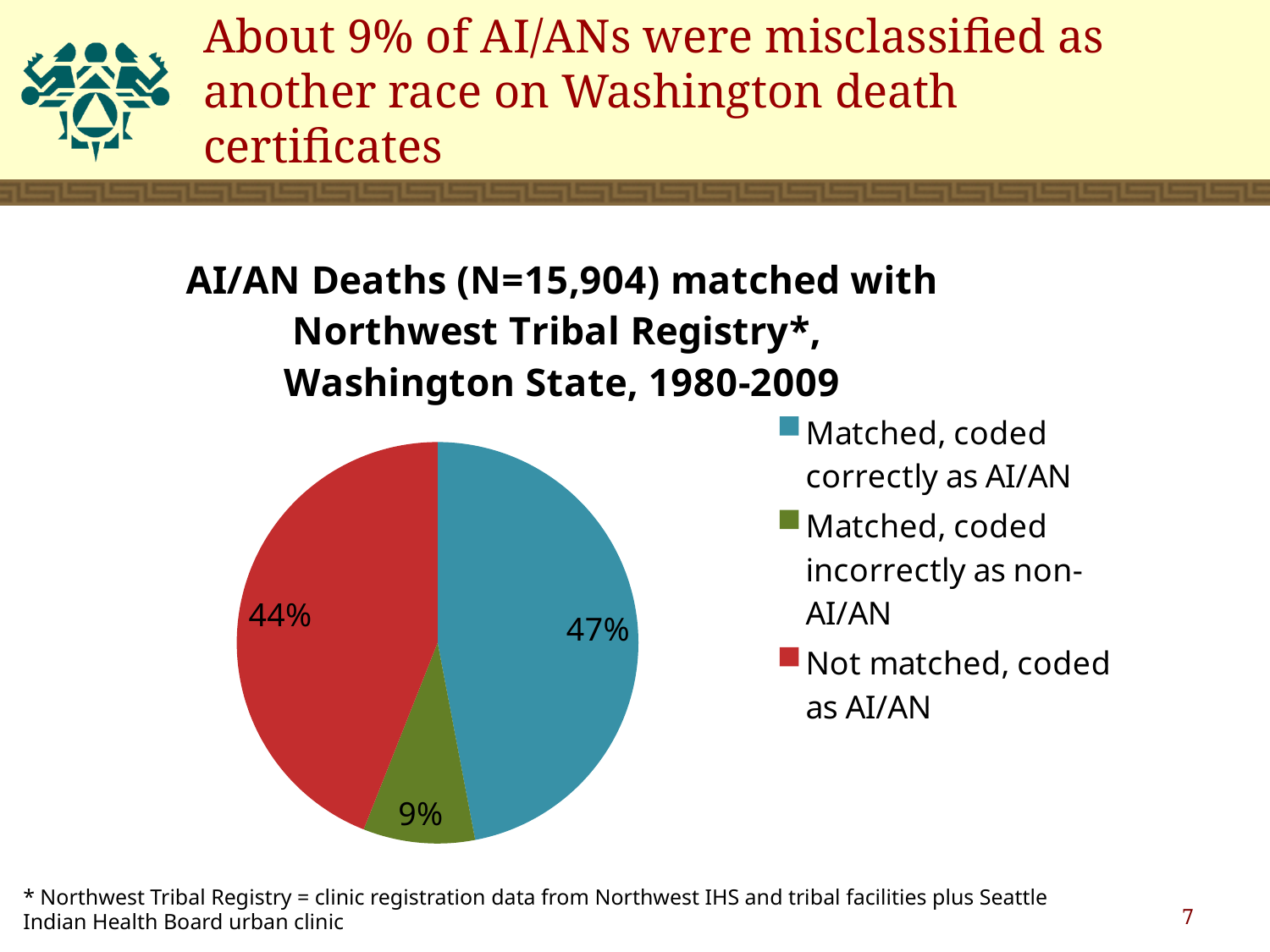
What share of AI/AN deaths were matched but coded incorrectly as non-AI/AN? 9% What is the total N of AI/AN deaths given in the chart title? 15,904 How many categories does the pie chart show? 3 What is the difference in percentage points between the 'Matched, coded correctly as AI/AN' slice and the 'Not matched, coded as AI/AN' slice? 3 percentage points What colour is the 'Not matched, coded as AI/AN' slice? red What kind of chart is shown on the slide? pie chart Which is larger: the 'Not matched, coded as AI/AN' slice or the 'Matched, coded incorrectly as non-AI/AN' slice? Not matched, coded as AI/AN Which category has the smallest slice of the pie? Matched, coded incorrectly as non-AI/AN What share of AI/AN deaths were matched and coded correctly as AI/AN? 47% What share of AI/AN deaths were not matched but coded as AI/AN? 44% How many entries does the legend list? 3 Which category has the largest slice of the pie? Matched, coded correctly as AI/AN